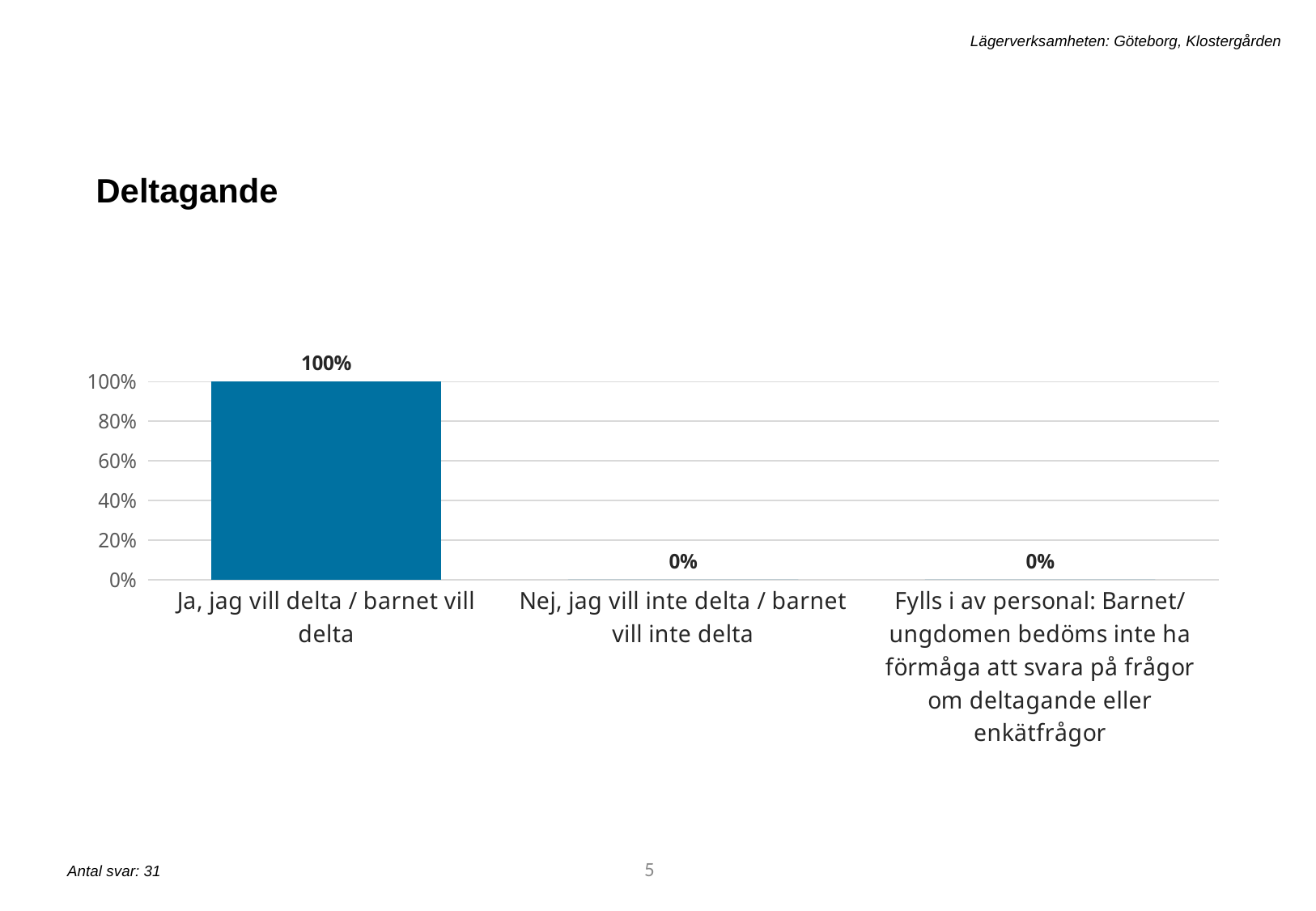
What is the value for the category "Fylls i av personal: Barnet/ ungdomen bedöms inte ha förmåga att svara på frågor om deltagande eller enkätfrågor"? 0% What kind of chart is shown on the slide? bar chart Is the value for "Ja, jag vill delta / barnet vill delta" greater or less than 80%? greater Which category has the highest value? Ja, jag vill delta / barnet vill delta What is the value for "Ja, jag vill delta / barnet vill delta"? 100% How many categories are shown on the x axis? 3 Which is larger: the value for "Ja, jag vill delta / barnet vill delta" or the value for "Nej, jag vill inte delta / barnet vill inte delta"? Ja, jag vill delta / barnet vill delta What is the highest value shown on the y axis? 100% What is the difference between the values for "Ja, jag vill delta / barnet vill delta" and "Nej, jag vill inte delta / barnet vill inte delta"? 100% What is the title of the chart? Deltagande How many categories have a value of 0%? 2 What is the value for "Nej, jag vill inte delta / barnet vill inte delta"? 0%